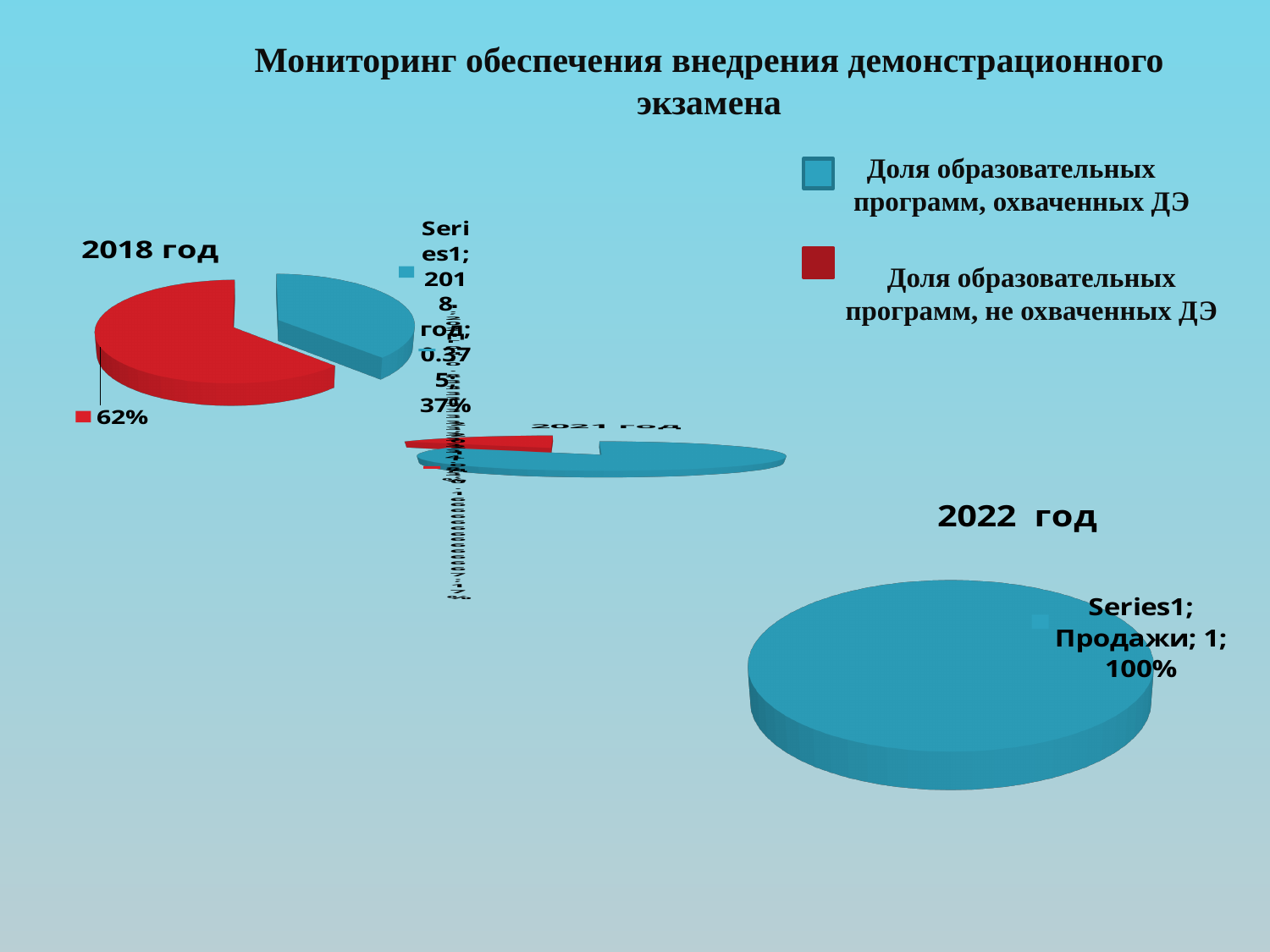
How many slices does the 2022 год pie chart have? 1 According to the legend, what does the blue colour represent? Доля образовательных программ, охваченных ДЭ How many entries does the legend on the slide list? 2 In the 2018 год pie chart, what percentage is shown for the blue slice (programs covered by ДЭ)? 37% In the 2022 год pie chart, what percentage is shown for the blue slice? 100% According to the legend, what does the red colour represent? Доля образовательных программ, не охваченных ДЭ In the 2018 год pie chart, which slice is larger, the red one or the blue one? the red one In the 2018 год pie chart, what is the difference between the red slice's percentage and the blue slice's percentage? 25% What type of chart is the 2022 год chart? pie chart What type of chart is the 2018 год chart? pie chart How many slices does the 2018 год pie chart have? 2 In the 2018 год pie chart, what percentage is shown for the red slice (programs not covered by ДЭ)? 62%